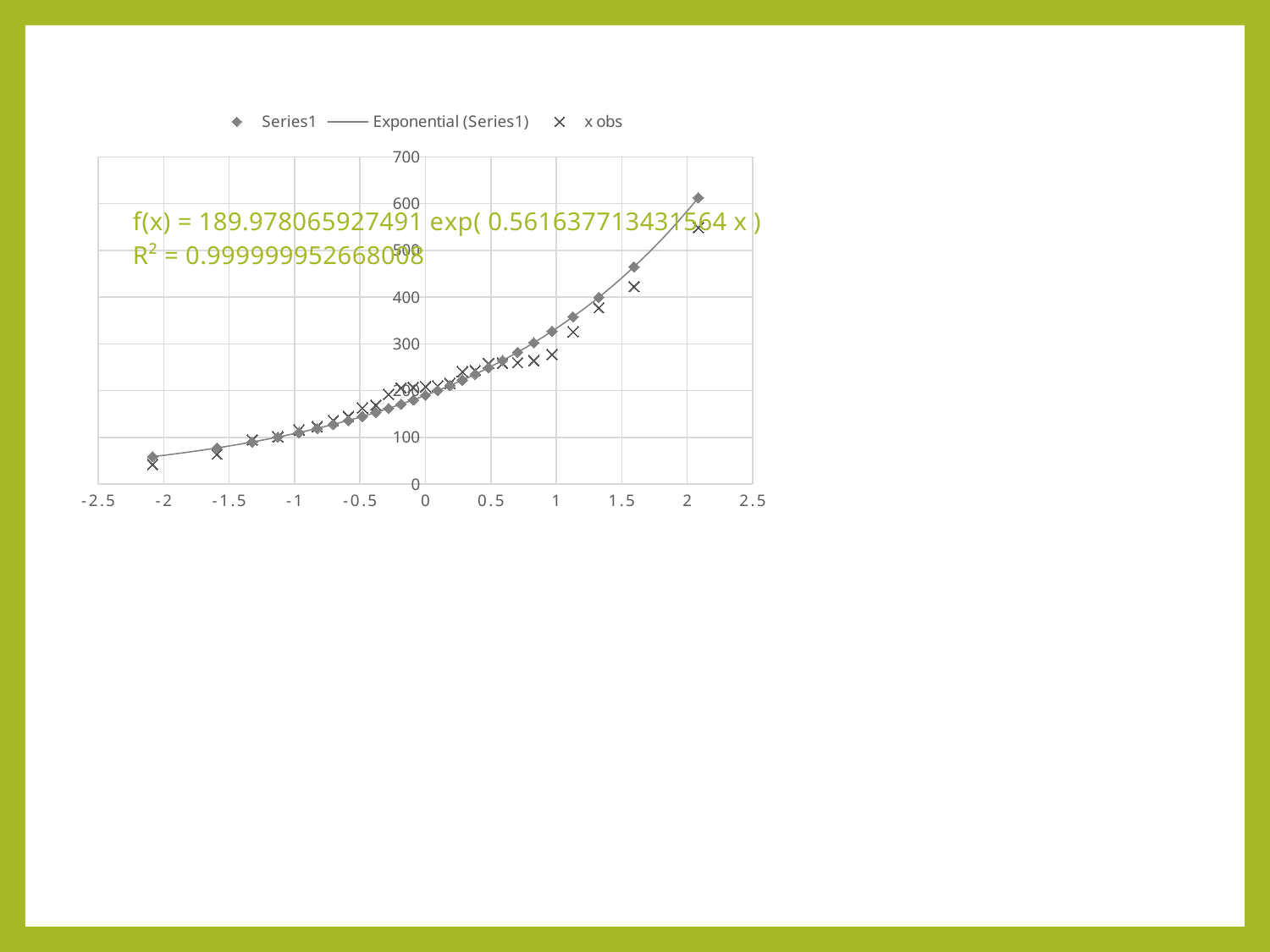
Is the highest Series1 point on the chart greater or less than 500? greater What is the maximum value shown on the vertical axis? 700 How many entries does the chart legend list? 3 What kind of chart is shown on the slide? Scatter chart What R² value is displayed on the chart? 0.999999952668008 Is the Series1 point at the far left of the chart (near x = -2) greater or less than 100? less Do the Series1 values rise or fall as x increases along the x axis? Rise Is the x obs marker near x = 2 greater or less than 500? greater What type of trendline is fitted to Series1 according to the legend? Exponential Near x = 2, which is higher: the Series1 diamond or the x obs marker? Series1